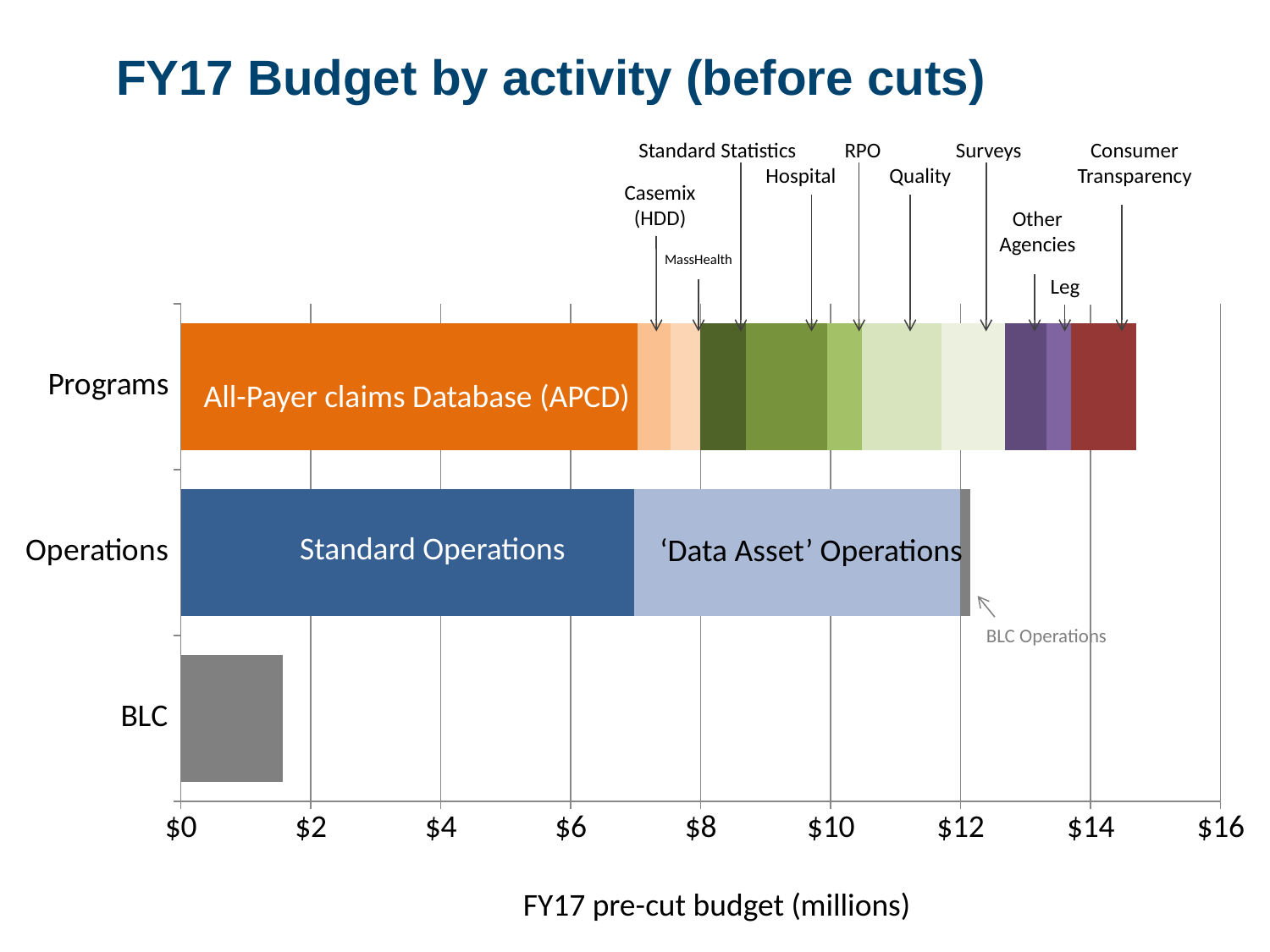
What kind of chart is shown on the slide? Stacked horizontal bar chart Within the Operations bar, which segment is larger: Standard Operations or 'Data Asset' Operations? Standard Operations Is the total value for BLC greater or less than $2? less Which category has the longest total bar? Programs Which is larger: the total for Programs or the total for Operations? Programs What is the title of the chart? FY17 Budget by activity (before cuts) Is the All-Payer claims Database (APCD) segment of the Programs bar greater or less than $6? greater Is the total value for Operations greater or less than $10? greater Which category has the shortest total bar? BLC How many categories (bars) are shown on the y axis? 3 What is the label of the x axis? FY17 pre-cut budget (millions)